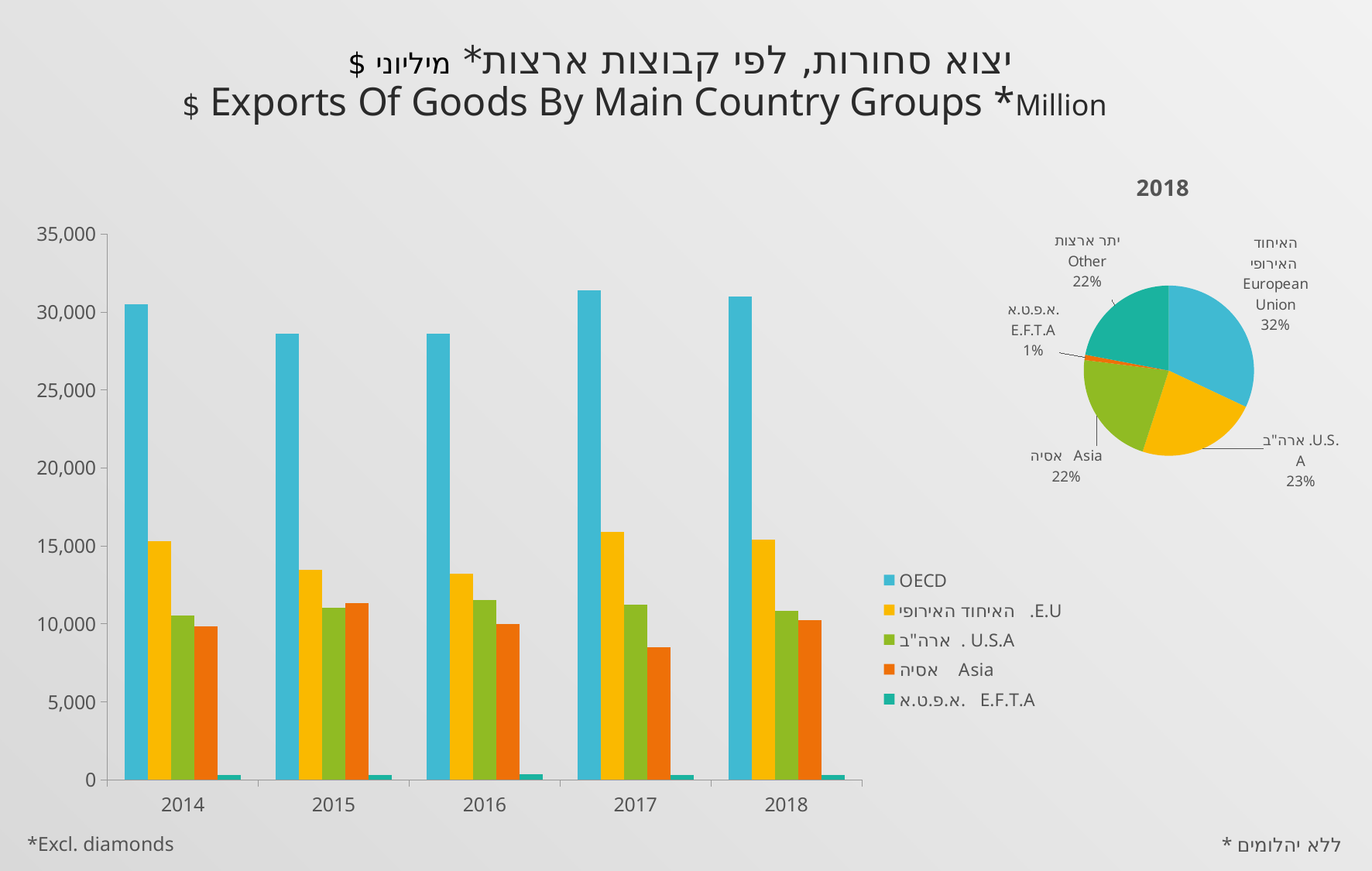
In the bar chart on the left, is the U.S.A value or the Asia value larger in 2017? U.S.A In the 2018 pie chart, what share of exports goes to E.F.T.A? 1% In the 2018 pie chart, how many slices are there? 5 In the 2018 pie chart, which country group has the smallest slice? E.F.T.A What kind of chart is the chart on the left showing exports from 2014 to 2018? Bar chart In the bar chart on the left, is the Asia value for 2017 greater or less than 10,000? less In the 2018 pie chart, what share of exports goes to the European Union? 32% In the 2018 pie chart, how many percentage points larger is the European Union share than the U.S.A share? 9 percentage points In the bar chart on the left, is the OECD value for 2017 greater or less than 30,000? greater In the bar chart on the left, how many series does the legend list? 5 In the bar chart on the left, which series has the highest value in every year? OECD In the 2018 pie chart, which country group has the largest slice? European Union